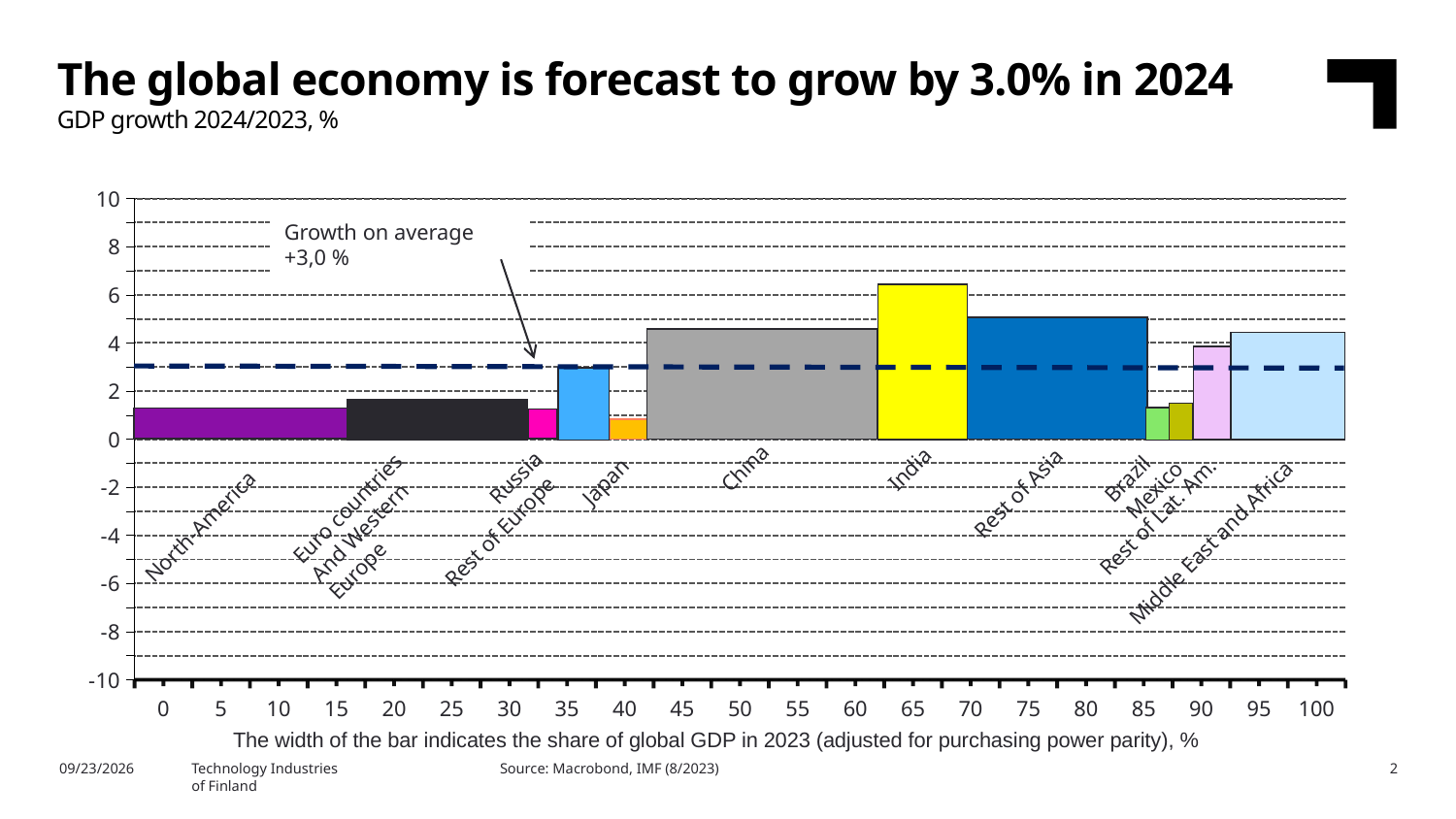
Which region has the highest forecast GDP growth in the chart? India How many regions/countries are shown as bars in the chart? 12 What kind of chart is shown on the slide? bar chart Which has the higher forecast GDP growth, Rest of Asia or Euro countries and Western Europe? Rest of Asia Is the value for North America greater or less than 2? less Which has the higher forecast GDP growth, China or India? India According to the note below the chart, what does the width of each bar indicate? The share of global GDP in 2023 (adjusted for purchasing power parity), % What is the average growth indicated by the dashed line in the chart? +3,0 % Is the value for India greater or less than 6? greater Is the value for Rest of Asia greater or less than 4? greater